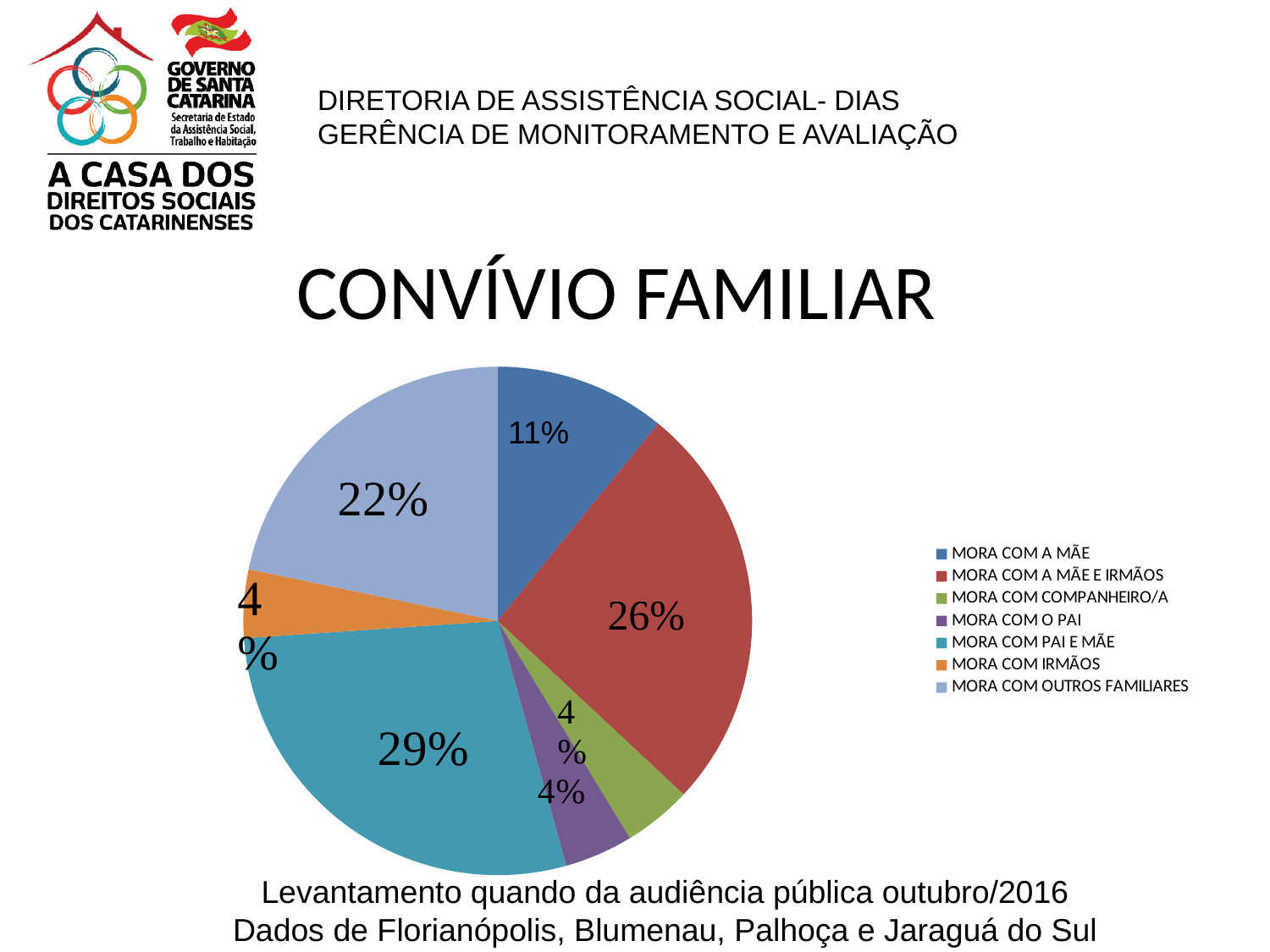
What is the title of the chart? CONVÍVIO FAMILIAR Which category has the largest share of the pie? MORA COM PAI E MÃE What percentage is shown for MORA COM A MÃE E IRMÃOS? 26% What type of chart is shown on the slide? pie chart How many categories does the pie chart have? 7 What percentage is shown for MORA COM OUTROS FAMILIARES? 22% Which is larger, the share for MORA COM OUTROS FAMILIARES or the share for MORA COM A MÃE? MORA COM OUTROS FAMILIARES What percentage is shown for MORA COM A MÃE? 11% What percentage is shown for MORA COM PAI E MÃE? 29% How many entries does the legend list? 7 What percentage is shown for MORA COM O PAI? 4% What is the difference between the shares for MORA COM PAI E MÃE and MORA COM A MÃE E IRMÃOS? 3%